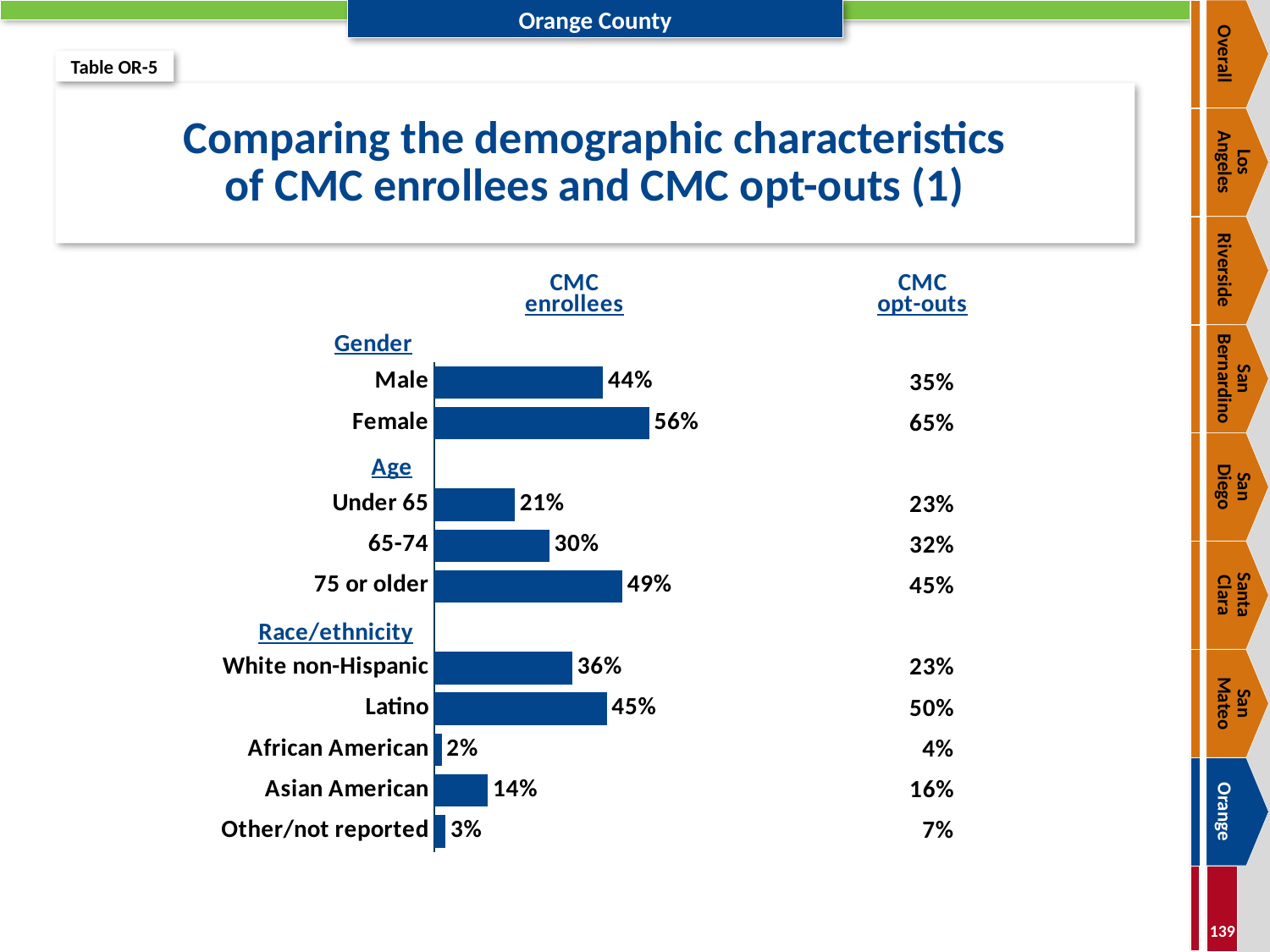
What percentage of CMC enrollees are 75 or older? 49% What type of chart is used to show the CMC enrollees percentages? Bar chart What percentage of CMC enrollees are Asian American? 14% Which race/ethnicity category has the highest percentage among CMC enrollees? Latino What is the difference between the Female and Male percentages for CMC enrollees? 12% What percentage of CMC opt-outs are Latino? 50% What percentage of CMC enrollees are Female? 56% Which is larger for CMC enrollees: the Under 65 percentage or the 65-74 percentage? 65-74 How many race/ethnicity categories are shown in the chart? 5 Which race/ethnicity category has the lowest percentage among CMC enrollees? African American What is the table number shown in the top-left corner of the slide? Table OR-5 What is the difference between the White non-Hispanic percentage for CMC enrollees and for CMC opt-outs? 13%